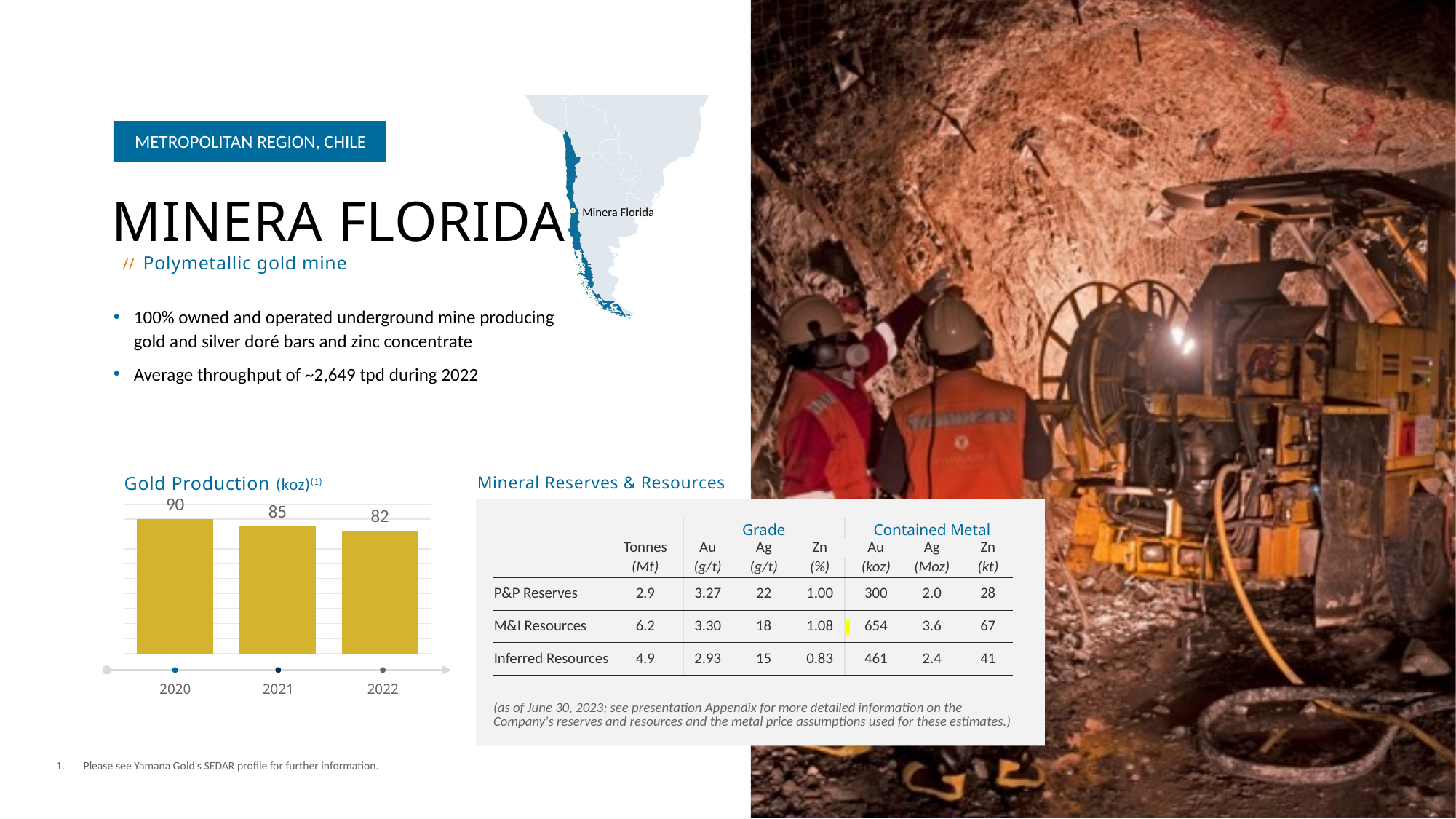
What is the difference in gold production between 2020 and 2022? 8 What was gold production in 2022 according to the Gold Production chart? 82 Which year had higher gold production, 2020 or 2021? 2020 How many years are shown in the Gold Production chart? 3 What unit is gold production measured in on the Gold Production chart? koz What was gold production in 2021 according to the Gold Production chart? 85 Which year has the highest gold production in the Gold Production chart? 2020 What type of chart is the Gold Production chart? Bar chart Does gold production rise or fall from 2020 to 2022 in the Gold Production chart? Fall What was gold production in 2020 according to the Gold Production chart? 90 Which year has the lowest gold production in the Gold Production chart? 2022 What is the difference in gold production between 2021 and 2022? 3